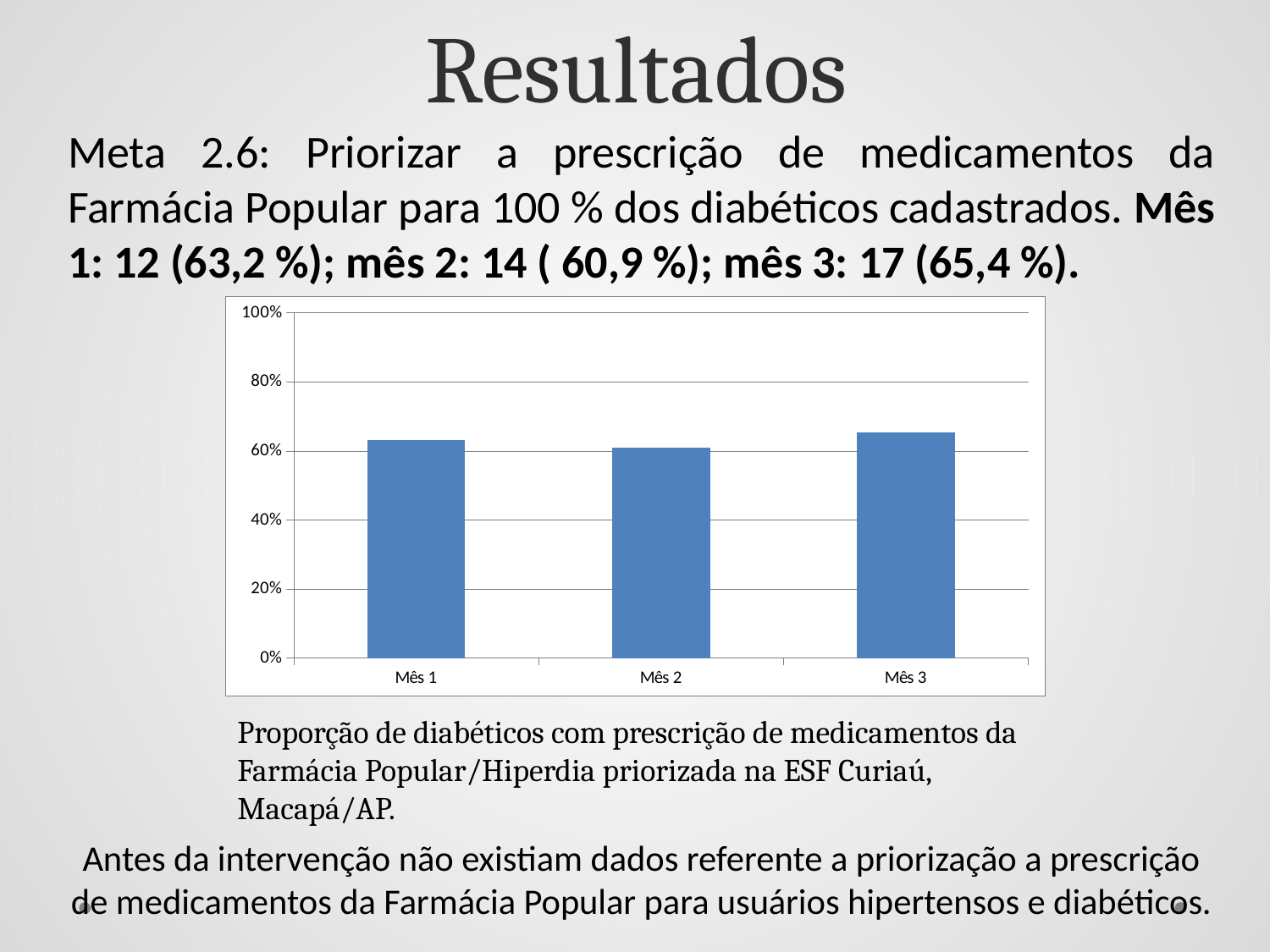
What is the highest value shown on the chart's vertical axis? 100% How many months (categories) are plotted on the chart? 3 According to the slide text, what proportion is shown for Mês 3? 65,4 % What kind of chart is shown on the slide? bar chart Using the percentages given in the slide text, what is the difference between Mês 3 and Mês 2? 4,5 % According to the slide text, what proportion is shown for Mês 2? 60,9 % Is the bar for Mês 2 greater or less than 40%? greater Is the bar for Mês 3 greater or less than 80%? less Which is larger, the bar for Mês 1 or the bar for Mês 2? Mês 1 Which month has the lowest bar on the chart? Mês 2 According to the slide text, what proportion is shown for Mês 1? 63,2 % Which month has the highest bar on the chart? Mês 3